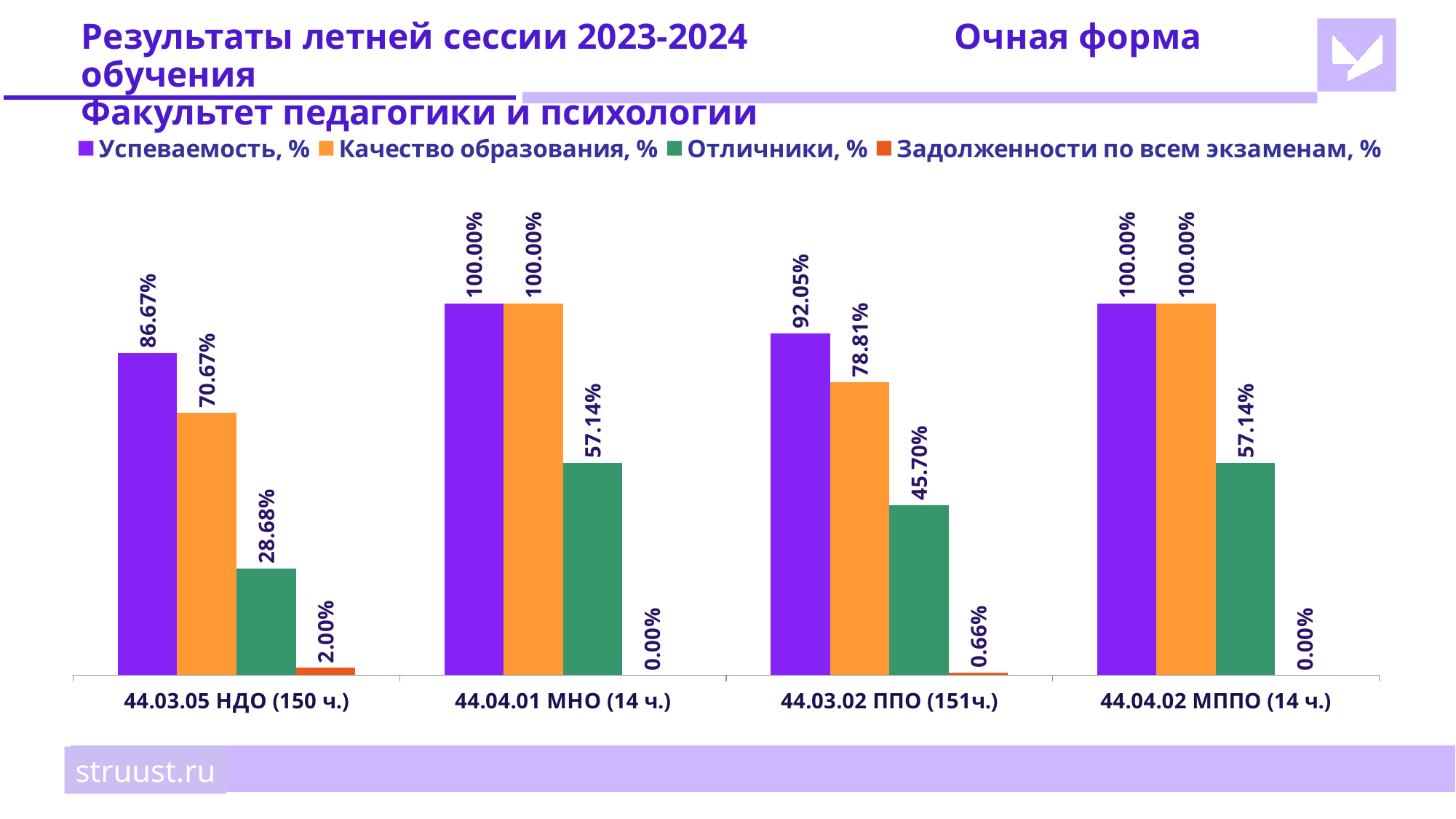
Which is larger: Отличники, % for 44.04.01 МНО (14 ч.) or for 44.03.02 ППО (151ч.)? 44.04.01 МНО (14 ч.) What is the value of Отличники, % for 44.04.02 МППО (14 ч.)? 57.14% What kind of chart is shown on the slide? Bar chart How many categories are shown on the x axis? 4 Which colour represents Задолженности по всем экзаменам, % in the legend? Red-orange What is the value of Успеваемость, % for 44.03.05 НДО (150 ч.)? 86.67% How many series does the legend list? 4 What is the difference between Успеваемость, % and Качество образования, % for 44.03.02 ППО (151ч.)? 13.24% Which category has the lowest value for Отличники, %? 44.03.05 НДО (150 ч.) Which category has the lowest value for Успеваемость, %? 44.03.05 НДО (150 ч.) What is the value of Качество образования, % for 44.03.02 ППО (151ч.)? 78.81% What is the value of Задолженности по всем экзаменам, % for 44.03.05 НДО (150 ч.)? 2.00%